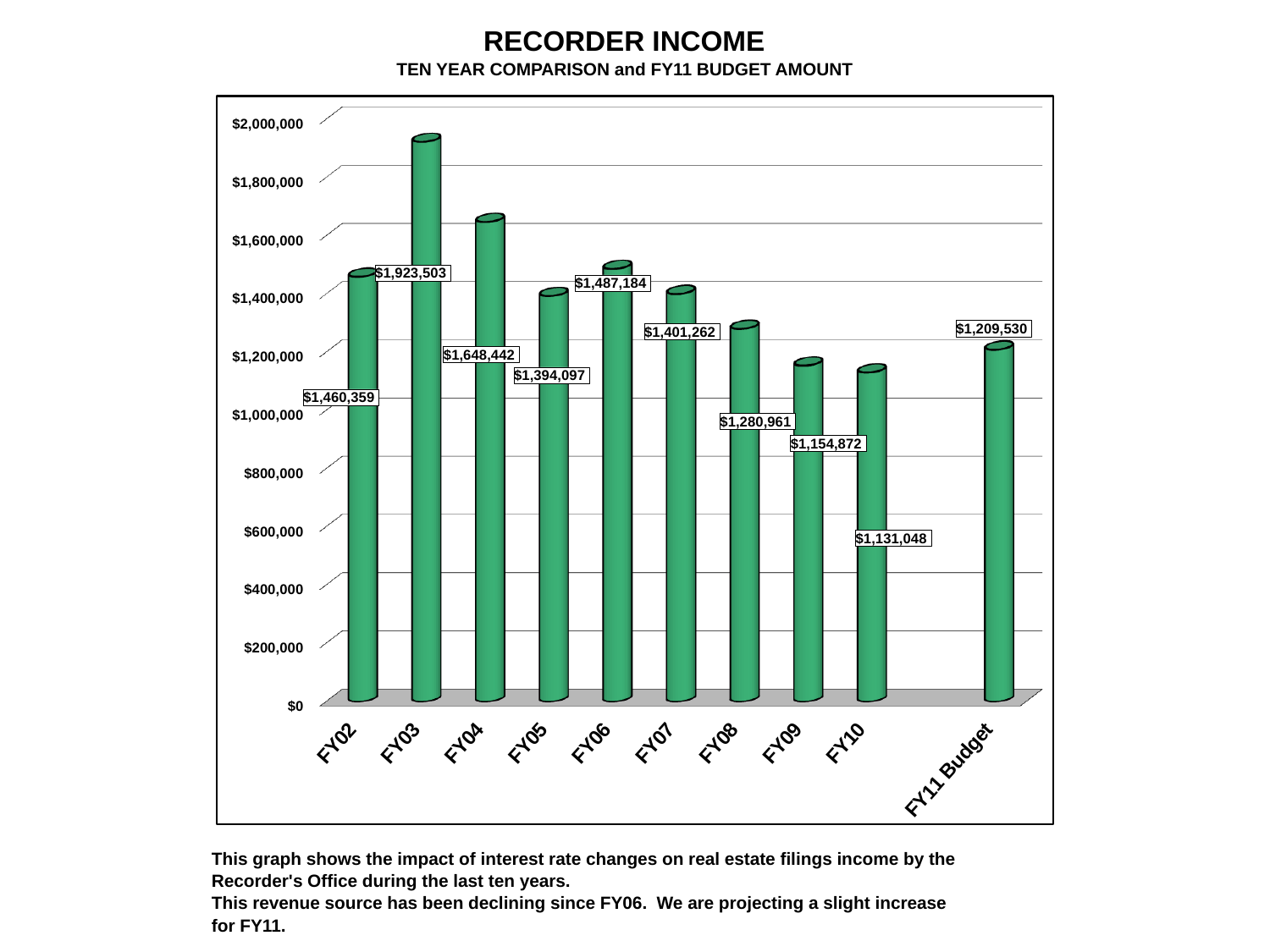
Is the value for FY09 greater or less than $1,200,000? less What is the Recorder Income value for FY10? $1,131,048 Do the values rise or fall from FY06 to FY10? fall Which category has the lowest value on the chart? FY10 What is the FY11 Budget amount shown on the chart? $1,209,530 What kind of chart is shown on the slide? bar chart Which is larger, the value for FY06 or the value for FY07? FY06 What is the title of the chart? RECORDER INCOME What is the difference between the FY03 and FY04 values? $275,061 What is the Recorder Income value for FY03? $1,923,503 How many bars are shown on the chart? 10 Which fiscal year has the highest Recorder Income? FY03